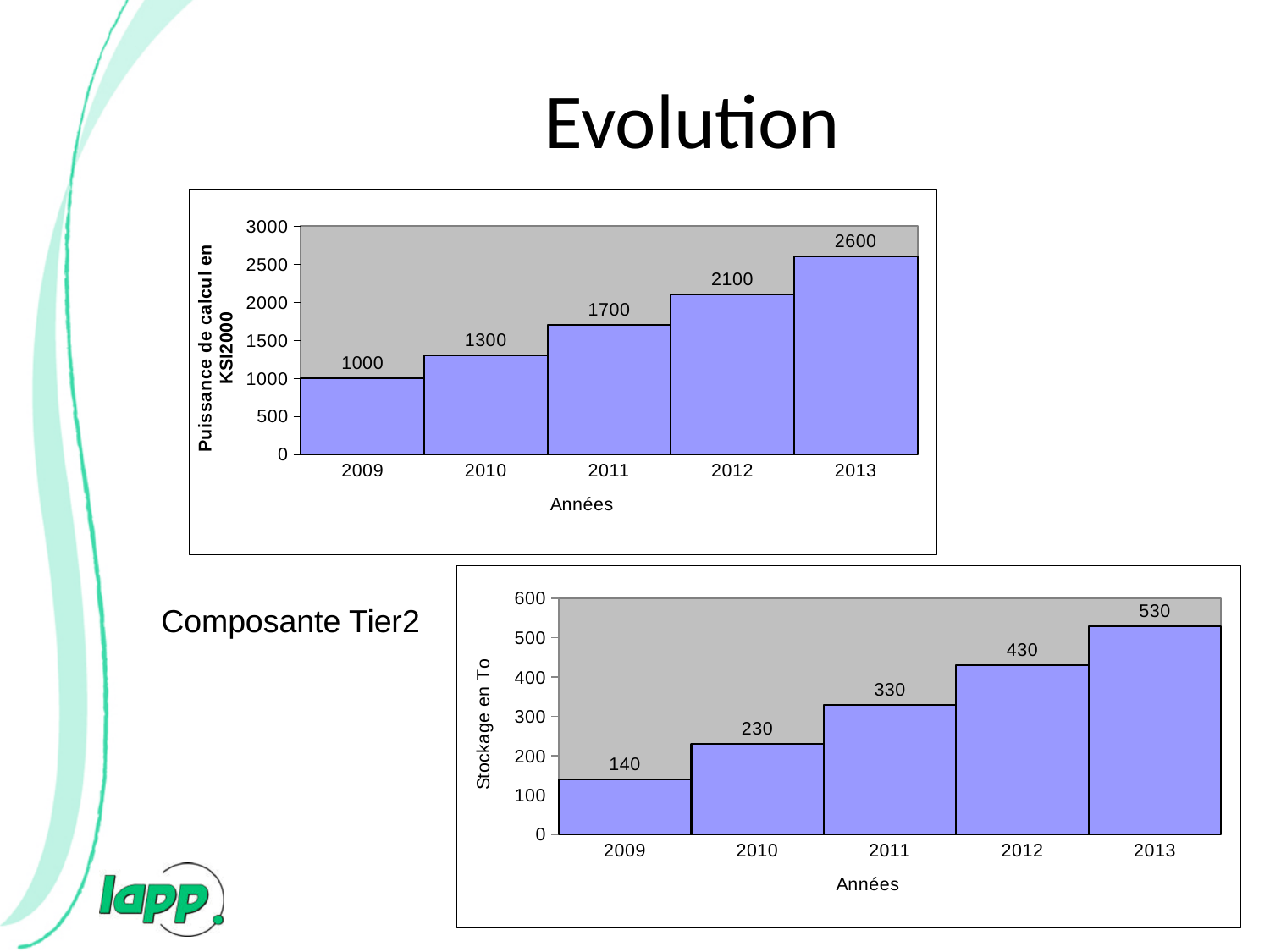
In the top chart (Puissance de calcul en KSI2000), what is the value for 2011? 1700 How many years are shown on the x axis of the bottom chart (Stockage en To)? 5 In the bottom chart (Stockage en To), which is larger, the value for 2010 or the value for 2012? 2012 In the bottom chart (Stockage en To), what is the value for 2012? 430 What is the x-axis label of the top chart (Puissance de calcul en KSI2000)? Années In the top chart (Puissance de calcul en KSI2000), what is the difference between the values for 2013 and 2009? 1600 In the top chart (Puissance de calcul en KSI2000), is the value for 2012 greater or less than 2000? greater What kind of chart is the top chart (Puissance de calcul en KSI2000)? bar chart In the bottom chart (Stockage en To), do the values rise or fall from 2009 to 2013? rise In the bottom chart (Stockage en To), which year has the lowest value? 2009 In the bottom chart (Stockage en To), what is the difference between the values for 2011 and 2010? 100 In the top chart (Puissance de calcul en KSI2000), which year has the highest value? 2013